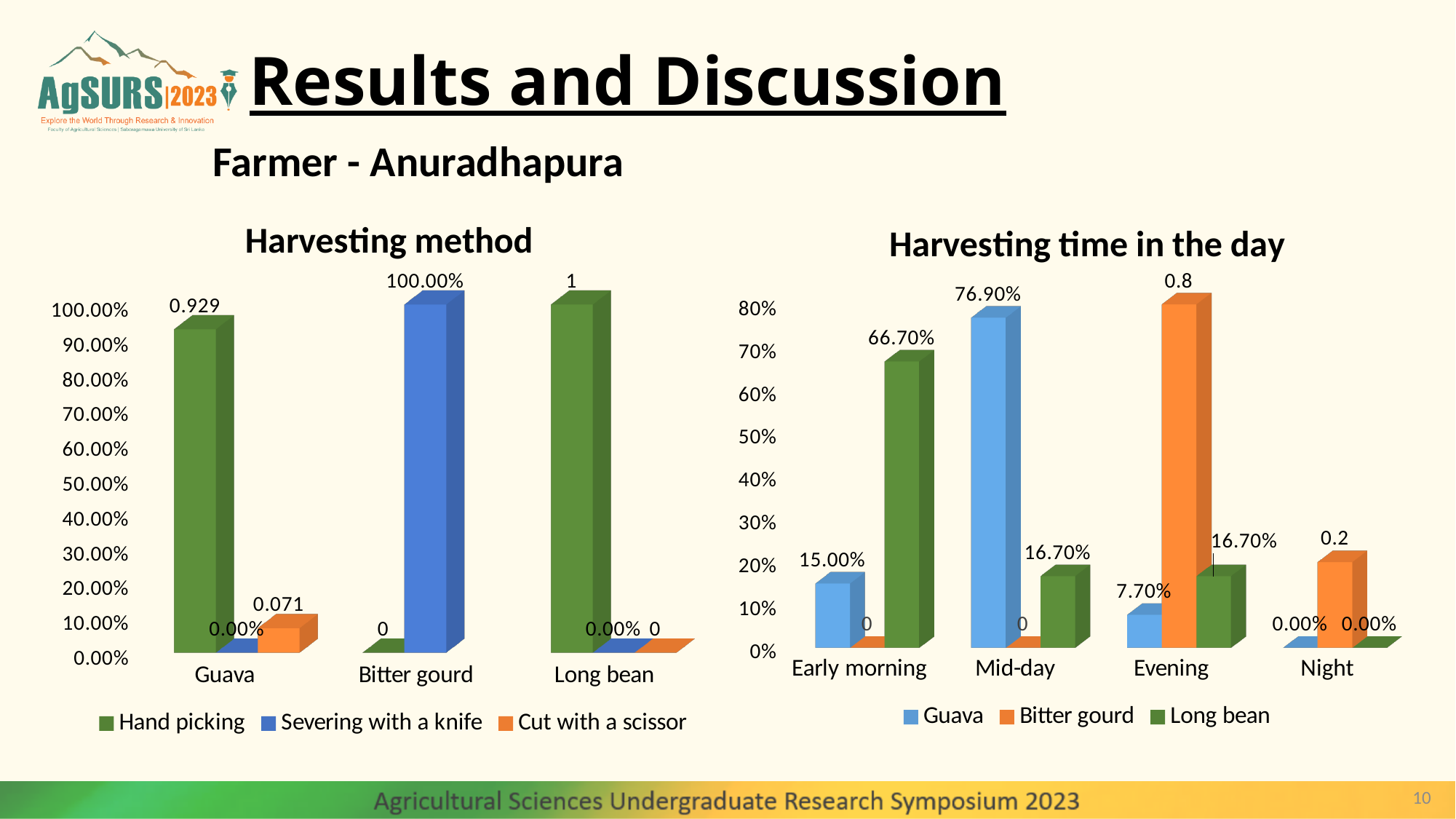
In the 'Harvesting method' chart, what is the value for Severing with a knife for Bitter gourd? 100.00% In the 'Harvesting time in the day' chart, what is the value for Long bean at Early morning? 66.70% In the 'Harvesting time in the day' chart, what is the difference between the Guava values at Mid-day and Early morning? 61.90% What kind of chart is 'Harvesting time in the day'? Bar chart In the 'Harvesting time in the day' chart, what is the value for Bitter gourd at Evening? 0.8 In the 'Harvesting method' chart, how many crop categories are shown on the x axis? 3 In the 'Harvesting method' chart, what is the value for Hand picking for Guava? 0.929 In the 'Harvesting time in the day' chart, which is larger at Early morning: Guava or Long bean? Long bean In the 'Harvesting time in the day' chart, at which time of day is the Guava value highest? Mid-day In the 'Harvesting method' chart, what is the value for Cut with a scissor for Guava? 0.071 In the 'Harvesting method' chart, how many series does the legend list? 3 In the 'Harvesting time in the day' chart, what is the value for Guava at Mid-day? 76.90%